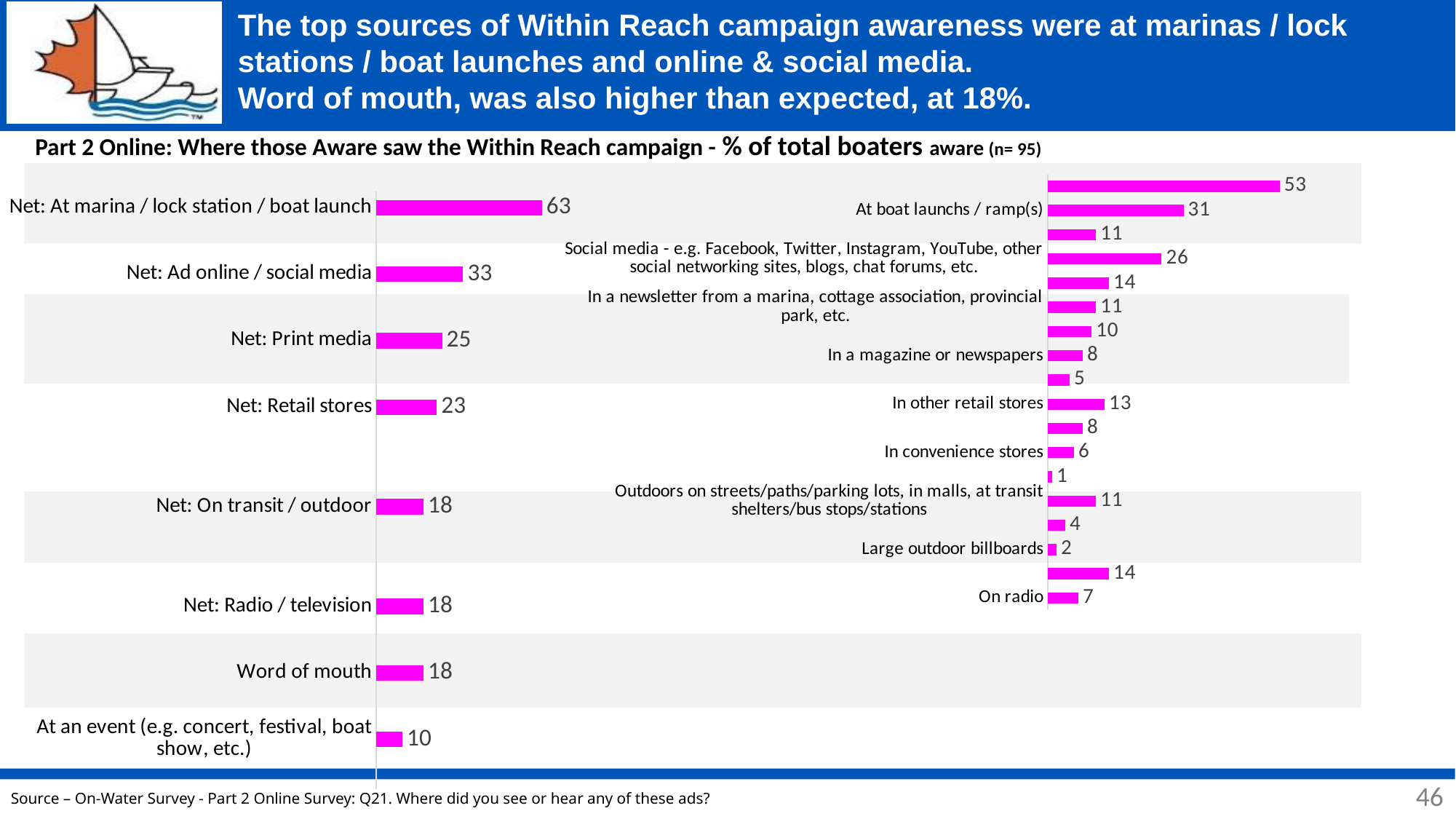
In the left chart, what is the difference between Net: At marina / lock station / boat launch and Net: Ad online / social media? 30 In the left chart, which category has the highest value? Net: At marina / lock station / boat launch In the right chart, which is larger: In other retail stores or In convenience stores? In other retail stores In the left chart, how many categories are shown? 8 In the left chart, what is the value for Net: At marina / lock station / boat launch? 63 What type of chart is the left chart? Bar chart In the right chart, what is the value for Large outdoor billboards? 2 In the right chart, what is the difference between the Social media value and the On radio value? 19 In the right chart, what is the value for At boat launchs / ramp(s)? 31 In the left chart, which category has the lowest value? At an event (e.g. concert, festival, boat show, etc.) In the left chart, what is the value for Word of mouth? 18 In the left chart, what is the value for Net: Print media? 25